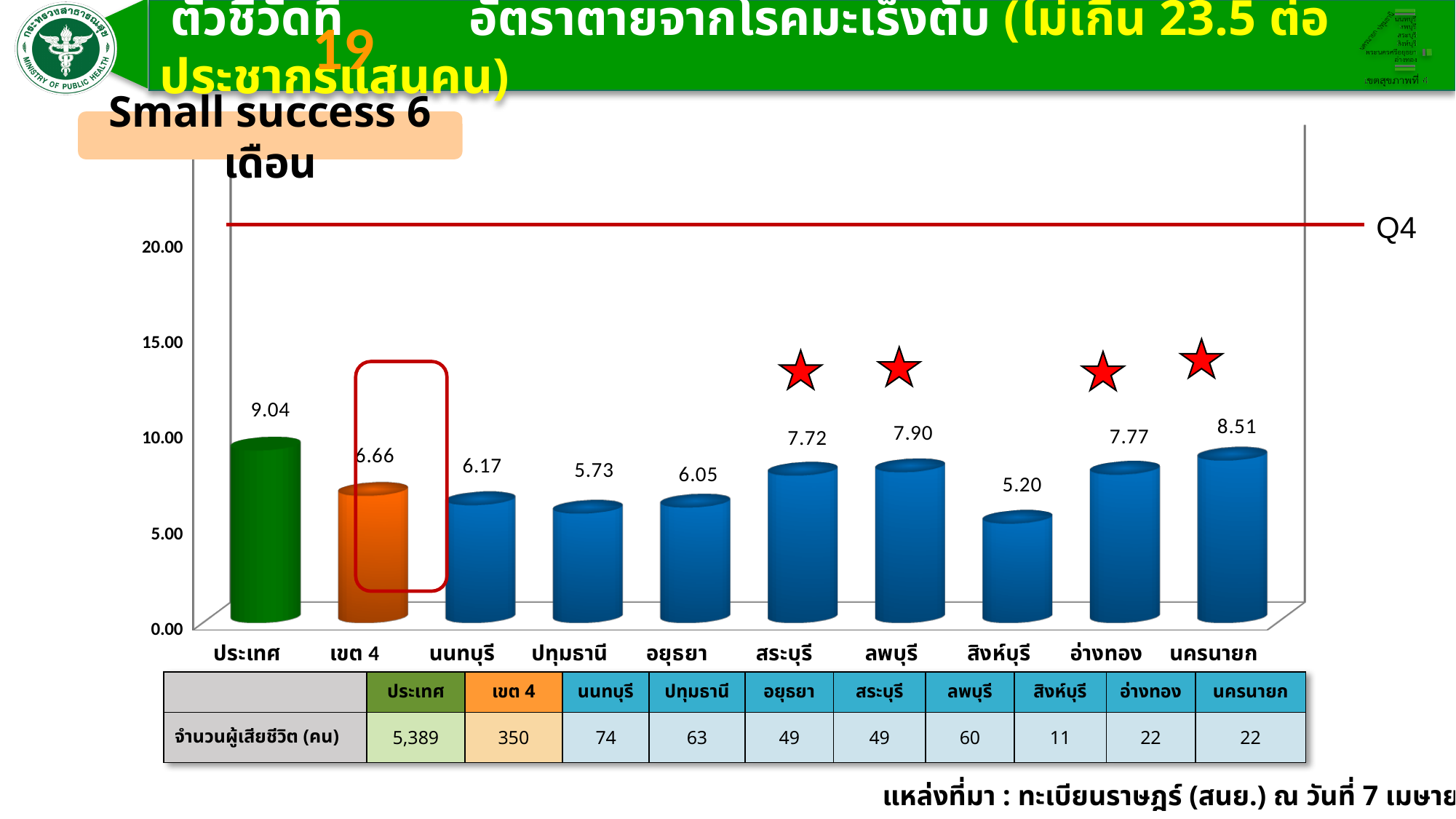
Which category has the lowest value in the chart? สิงห์บุรี Is the value for นครนายก greater or less than 10.00? less Which category has the highest value in the chart? ประเทศ What is the value shown for นครนายก? 8.51 What is the value shown for เขต 4? 6.66 What is the value shown for ประเทศ? 9.04 What colour is the bar for เขต 4? orange What kind of chart is shown on the slide? bar chart Which is larger, the value for ลพบุรี or the value for สระบุรี? ลพบุรี What is the difference between the values for ประเทศ and เขต 4? 2.38 How many categories are plotted on the x axis of the chart? 10 What is the value shown for สิงห์บุรี? 5.20